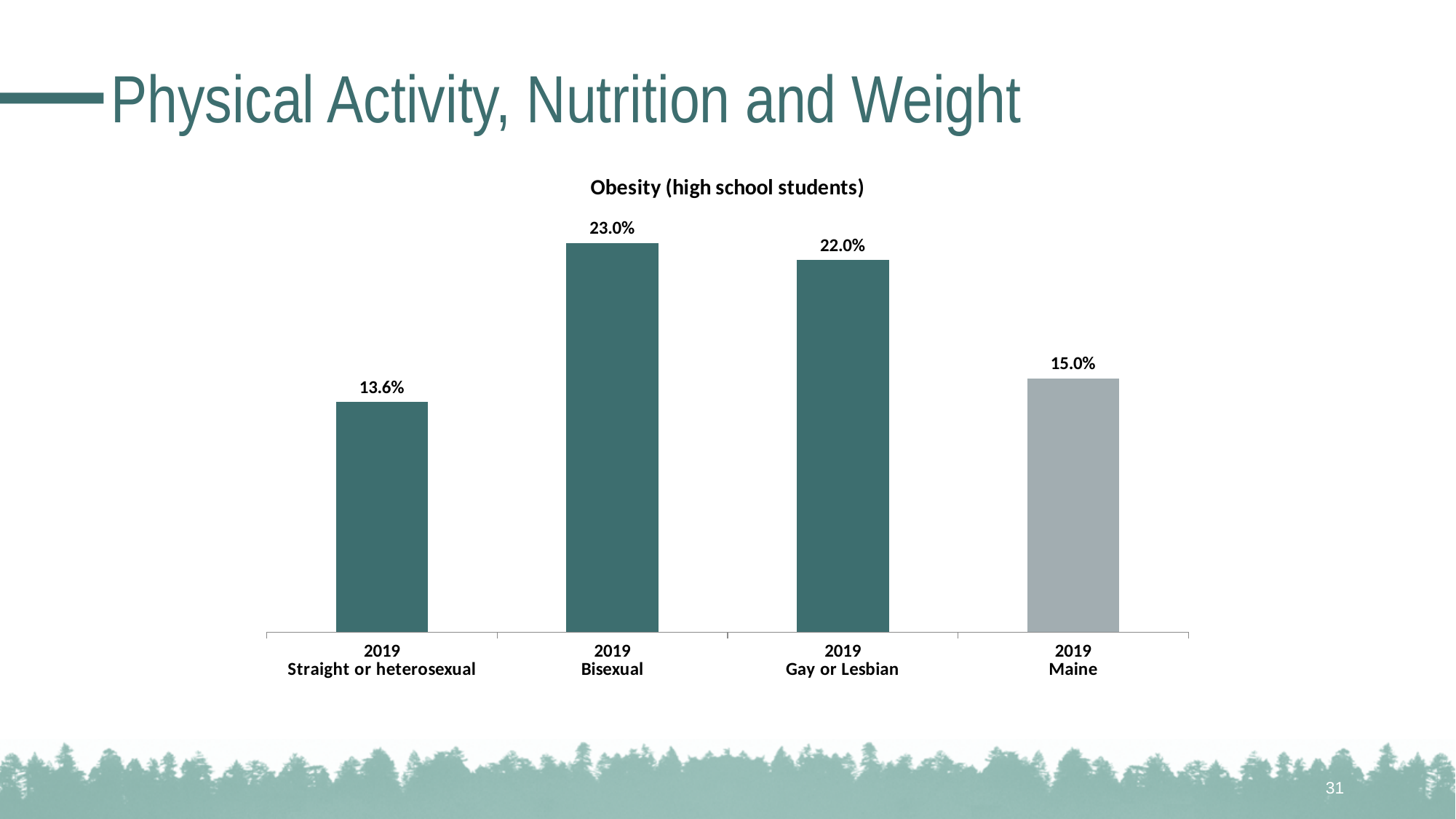
What is the obesity rate for Bisexual high school students in 2019? 23.0% What is the difference between the obesity rate for Gay or Lesbian students and Straight or heterosexual students? 8.4% How many bars are shown in the chart? 4 What is the title of the chart? Obesity (high school students) Which group has the lowest obesity rate? Straight or heterosexual Which is larger, the obesity rate for Maine or for Straight or heterosexual students? Maine What is the obesity rate for Gay or Lesbian high school students in 2019? 22.0% What is the obesity rate for Maine high school students overall in 2019? 15.0% Which group has the highest obesity rate? Bisexual What is the obesity rate for Straight or heterosexual high school students in 2019? 13.6% What is the difference between the obesity rate for Bisexual students and the Maine rate? 8.0% What type of chart is shown on the slide? Bar chart